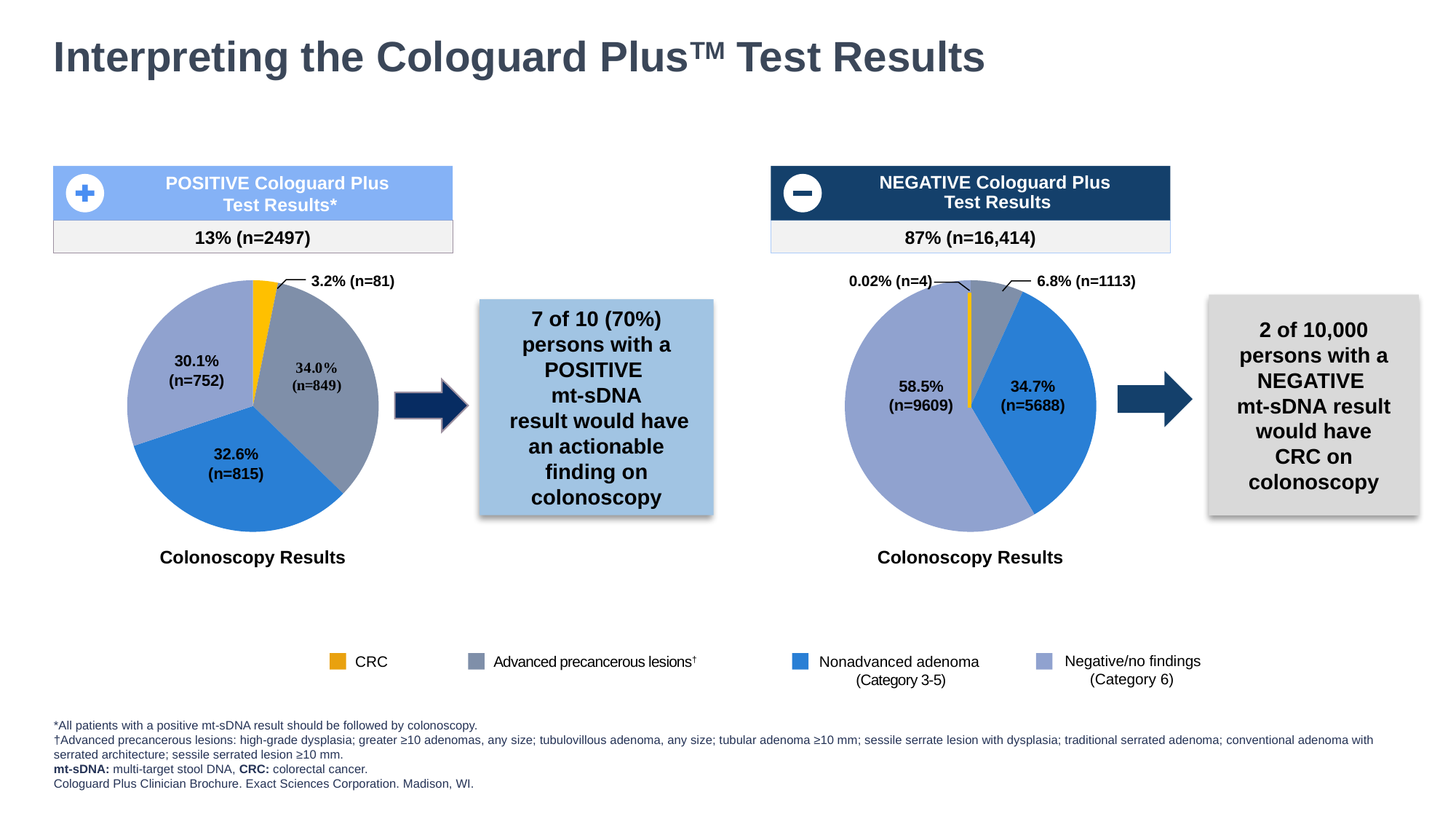
Which is larger: the nonadvanced adenoma share in the POSITIVE pie chart or the nonadvanced adenoma share in the NEGATIVE pie chart? NEGATIVE pie chart (34.7%) In the POSITIVE Cologuard Plus test results pie chart, which colonoscopy result category has the smallest share? CRC In the POSITIVE Cologuard Plus test results pie chart, how many persons had advanced precancerous lesions? n=849 What colour represents CRC in the pie charts? Yellow In the NEGATIVE Cologuard Plus test results pie chart, which colonoscopy result category has the largest share? Negative/no findings In the NEGATIVE Cologuard Plus test results pie chart, what percentage of colonoscopy results were negative/no findings? 58.5% In the NEGATIVE Cologuard Plus test results pie chart, how many persons had CRC? n=4 How many categories does the shared legend list for the pie charts? 4 In the POSITIVE Cologuard Plus test results pie chart, which colonoscopy result category has the largest share? Advanced precancerous lesions What kind of chart is used to show the colonoscopy results for the POSITIVE Cologuard Plus test results? Pie chart In the NEGATIVE Cologuard Plus test results pie chart, what is the difference in percentage points between negative/no findings and nonadvanced adenoma? 23.8 In the POSITIVE Cologuard Plus test results pie chart, what percentage of colonoscopy results were CRC? 3.2%